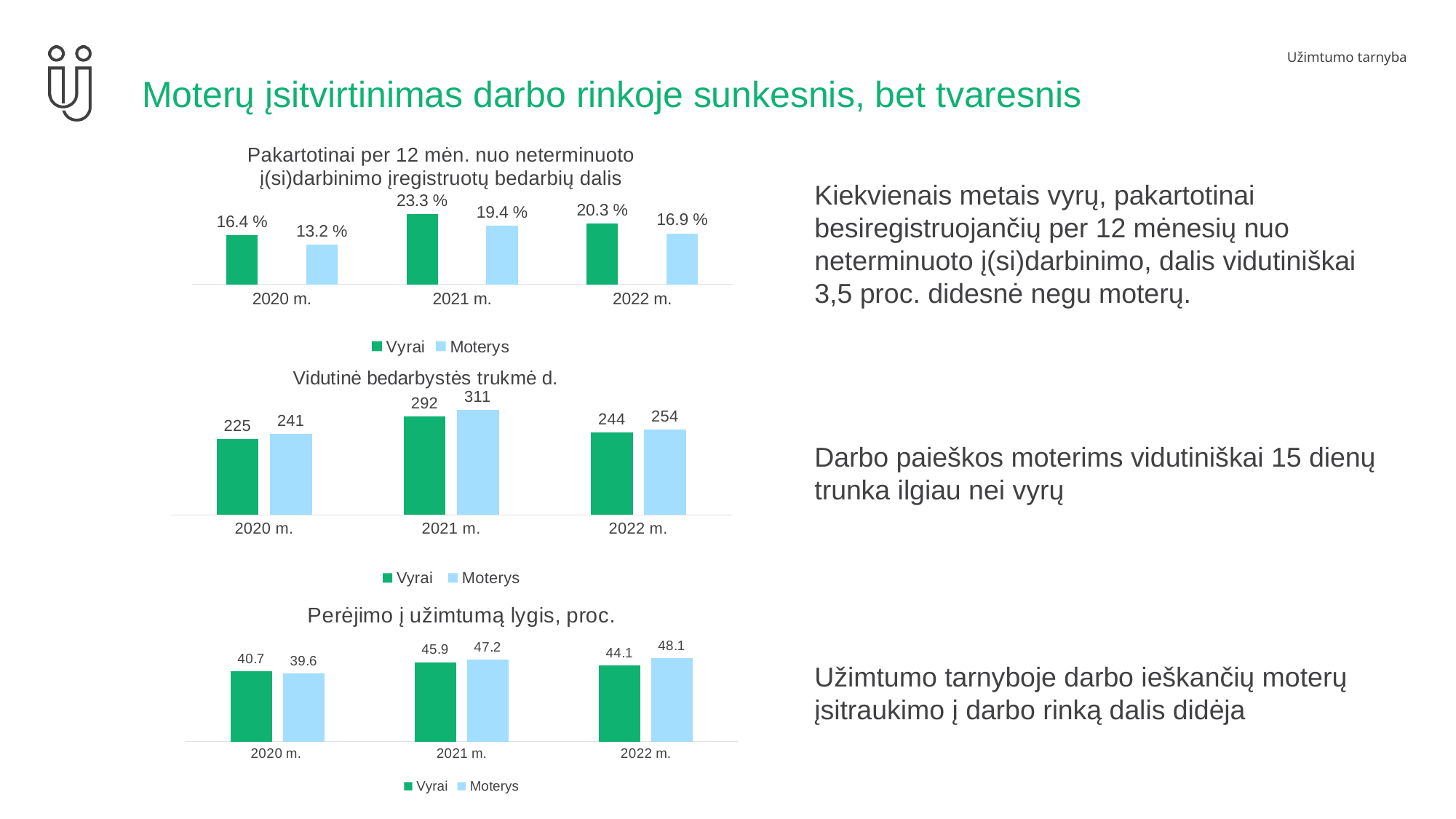
In the top chart (Pakartotinai per 12 mėn. nuo neterminuoto į(si)darbinimo įregistruotų bedarbių dalis), what is the value for Vyrai in 2021 m.? 23.3 % In the top chart (Pakartotinai per 12 mėn. ...), what is the difference between Vyrai and Moterys in 2022 m.? 3.4 % In the top chart (Pakartotinai per 12 mėn. ...), which year has the highest value for Moterys? 2021 m. In the bottom chart (Perėjimo į užimtumą lygis, proc.), does the value for Moterys rise or fall from 2020 m. to 2022 m.? rise In the middle chart (Vidutinė bedarbystės trukmė d.), which year has the lowest value for Vyrai? 2020 m. In the bottom chart (Perėjimo į užimtumą lygis, proc.), what is the value for Moterys in 2022 m.? 48.1 In the middle chart (Vidutinė bedarbystės trukmė d.), what is the difference between Moterys and Vyrai in 2020 m.? 16 How many series does the legend of the bottom chart (Perėjimo į užimtumą lygis, proc.) list? 2 In the top chart (Pakartotinai per 12 mėn. ...), what is the value for Moterys in 2020 m.? 13.2 % In the middle chart (Vidutinė bedarbystės trukmė d.), what is the value for Moterys in 2021 m.? 311 What type of chart is the middle chart (Vidutinė bedarbystės trukmė d.)? bar chart In the middle chart (Vidutinė bedarbystės trukmė d.), which is larger in 2022 m., Vyrai or Moterys? Moterys